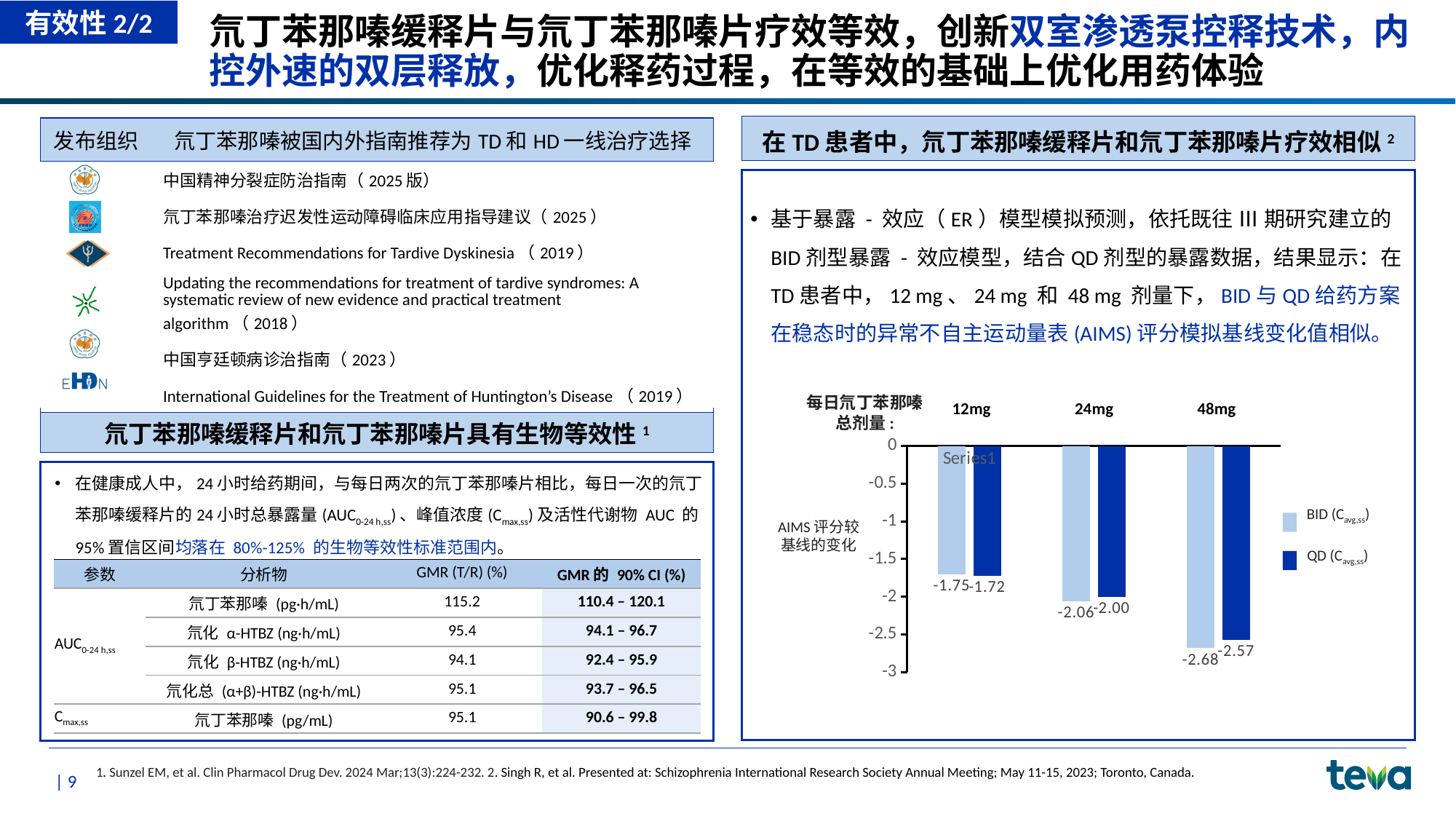
Which dose group shows the most negative (largest) change from baseline in AIMS score for the BID series? 48mg What is the QD value for the 48mg dose in the AIMS score change chart? -2.57 What type of chart is used to show the AIMS score change from baseline? Bar chart What is the QD value for the 24mg dose in the AIMS score change chart? -2.00 Which dose group shows the smallest change from baseline in AIMS score for the QD series? 12mg What is the difference between the BID and QD values at the 48mg dose? 0.11 What is the BID value for the 12mg dose in the AIMS score change chart? -1.75 How many series does the legend of the AIMS score change chart list? 2 At the 48mg dose, which series has the more negative value, BID or QD? BID How many dose groups are shown on the x axis of the AIMS score change chart? 3 What is the BID value for the 48mg dose in the AIMS score change chart? -2.68 What is the difference between the BID and QD values at the 24mg dose? 0.06